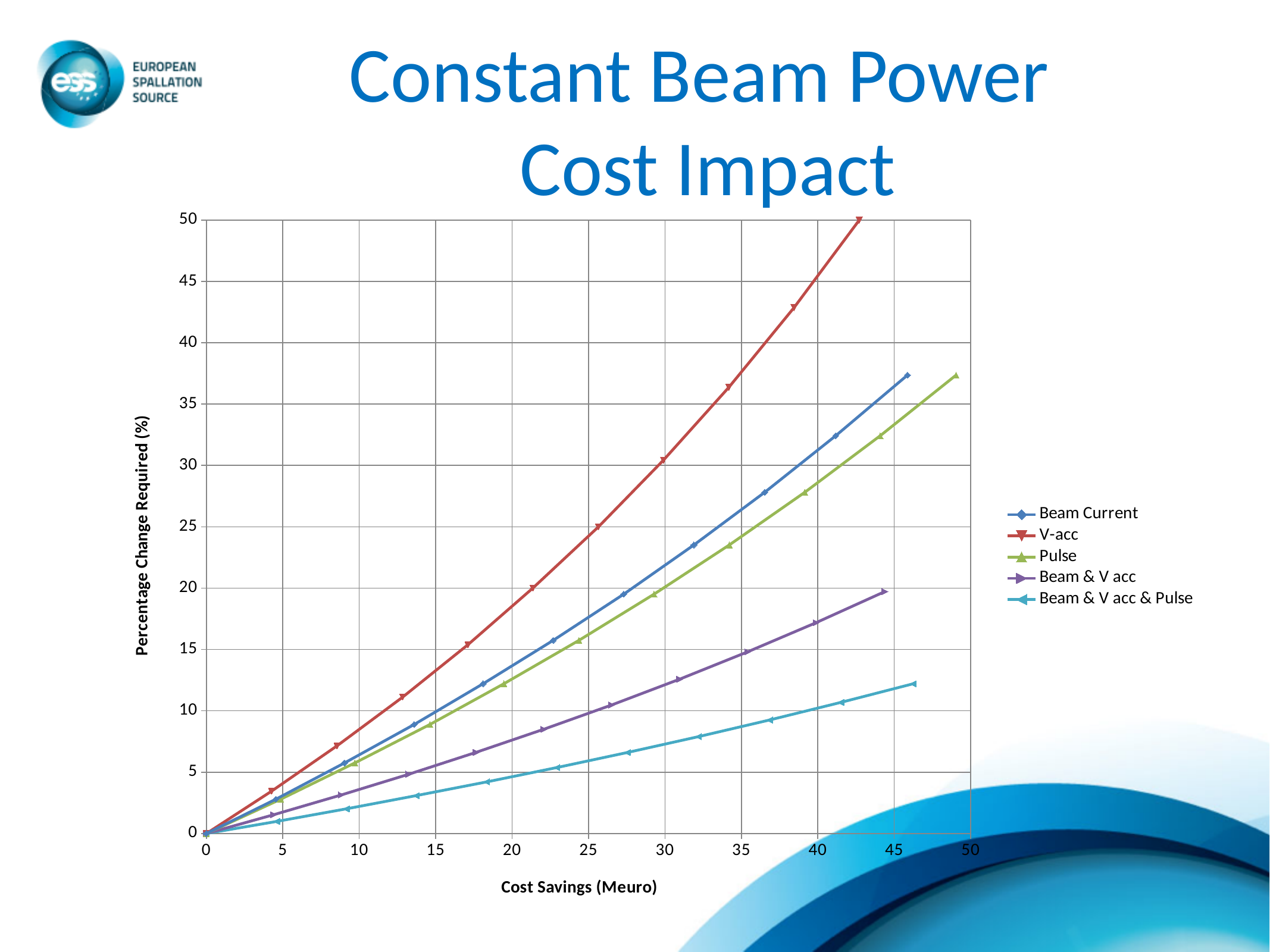
Is the percentage change required for Beam Current at 45 Meuro cost savings greater or less than 30? greater Is the percentage change required for Beam & V acc & Pulse at 40 Meuro cost savings greater or less than 15? less How many series does the legend list? 5 Which series requires the lowest percentage change at 30 Meuro of cost savings? Beam & V acc & Pulse What are the series names listed in the legend? Beam Current, V-acc, Pulse, Beam & V acc, Beam & V acc & Pulse What is the percentage change required for Beam Current at 0 Meuro of cost savings? 0 What kind of chart is shown on the slide? line chart Which series requires the highest percentage change at 30 Meuro of cost savings? V-acc Do the percentage change values rise or fall as cost savings increase? rise Is the percentage change required for V-acc at 30 Meuro cost savings greater or less than 25? greater At 40 Meuro of cost savings, which requires a larger percentage change: Beam & V acc or Beam & V acc & Pulse? Beam & V acc What is the title of the x axis? Cost Savings (Meuro)